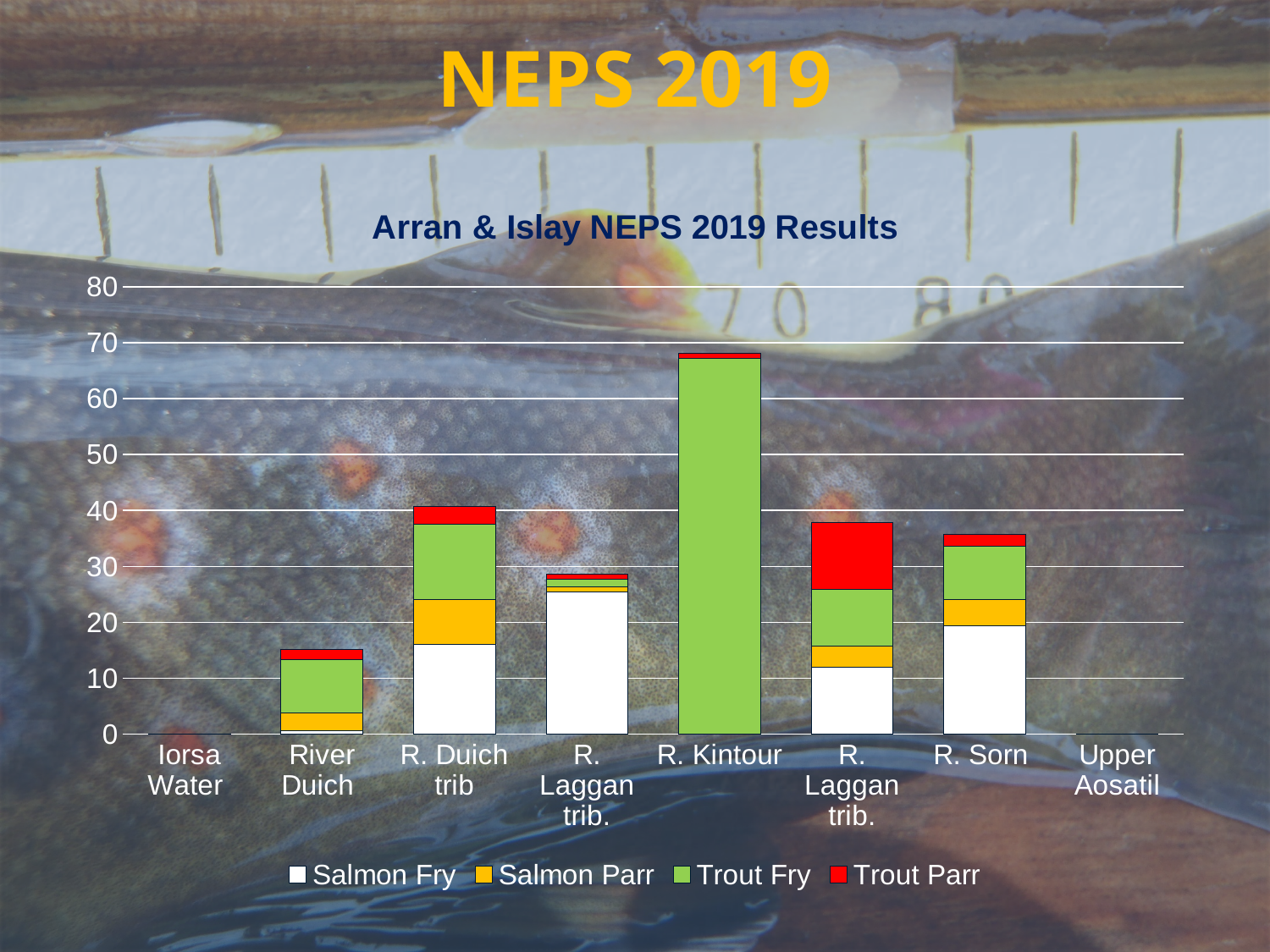
Is the total value for R. Duich trib greater or less than 30? greater Which site has the tallest stacked bar? R. Kintour Is the total value for R. Sorn greater or less than 30? greater Which colour represents Trout Fry in the legend? Green Which has the larger total bar, River Duich or R. Sorn? R. Sorn Is the total value for R. Kintour greater or less than 60? greater Which has the larger total bar, R. Kintour or R. Duich trib? R. Kintour How many series does the legend list? 4 What is the title of the chart? Arran & Islay NEPS 2019 Results How many site categories are shown along the x axis? 8 What kind of chart is shown on the slide? Stacked bar chart